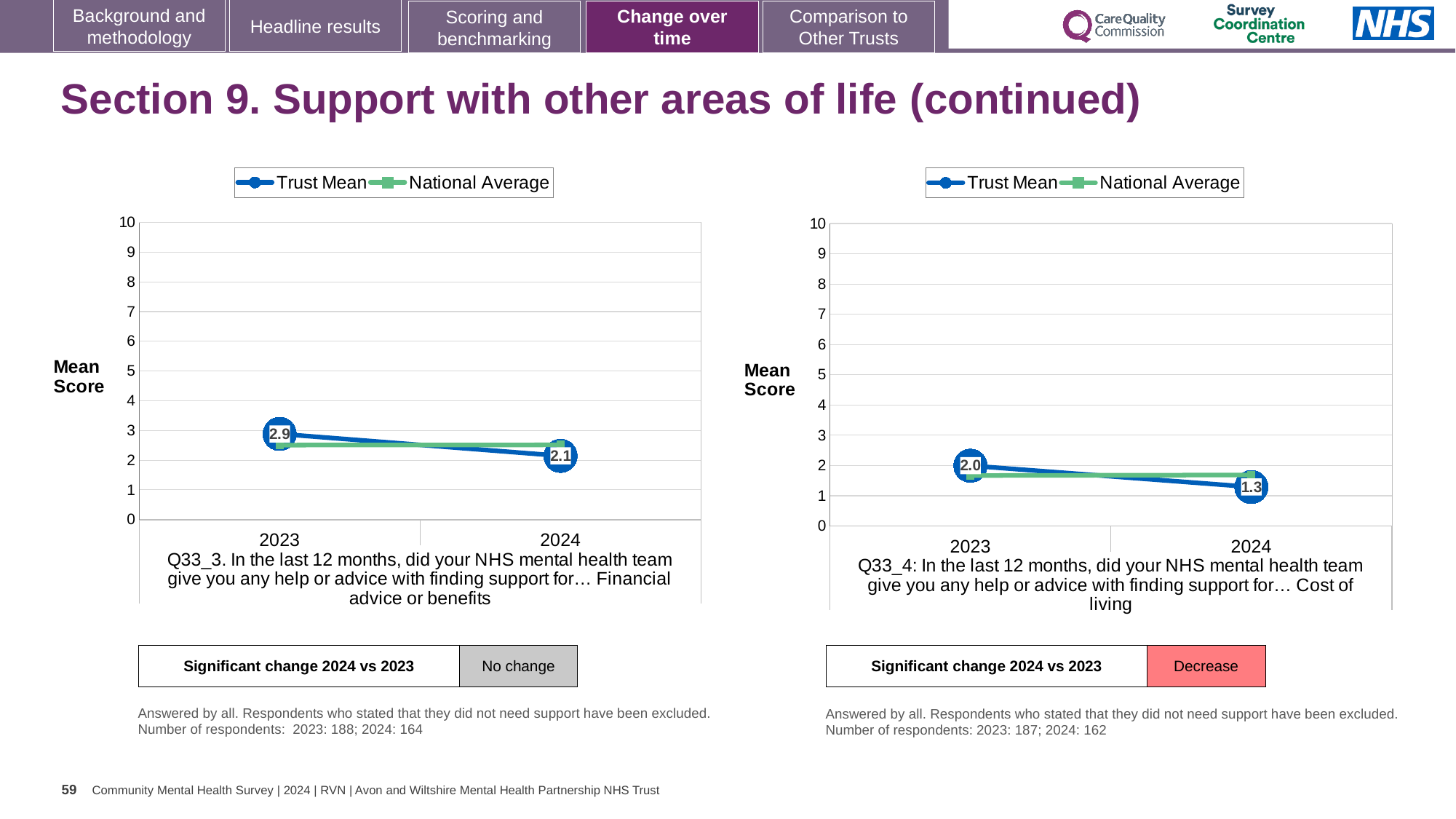
In the left chart (Q33_3, Financial advice or benefits), what is the Trust Mean for 2023? 2.9 In the right chart (Q33_4), what is the difference between the Trust Mean in 2023 and 2024? 0.7 In the left chart (Q33_3), by how much did the Trust Mean change from 2023 to 2024? 0.8 In the left chart (Q33_3), is the National Average for 2023 greater or less than 3? less In the right chart (Q33_4, Cost of living), what is the Trust Mean for 2024? 1.3 In the left chart (Q33_3, Financial advice or benefits), what is the Trust Mean for 2024? 2.1 In the left chart (Q33_3), does the Trust Mean rise or fall from 2023 to 2024? fall How many series does the legend of the right chart (Q33_4) list? 2 In the right chart (Q33_4), is the National Average for 2024 greater or less than 1? greater In the right chart (Q33_4, Cost of living), what is the Trust Mean for 2023? 2.0 What kind of chart is used on the left of the slide (Q33_3)? line chart In the right chart (Q33_4), which year has the higher Trust Mean, 2023 or 2024? 2023